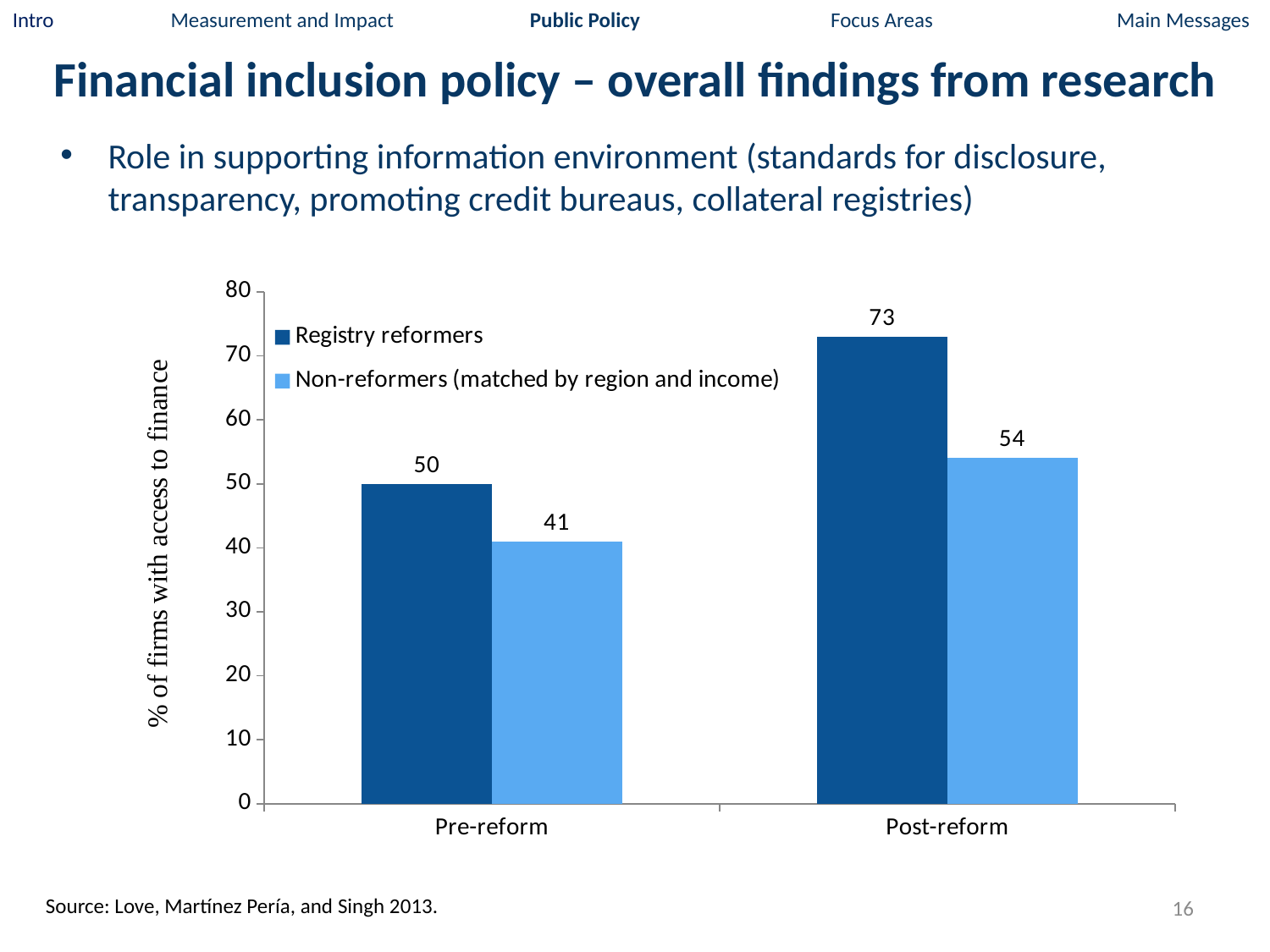
By how much did the Registry reformers value increase from Pre-reform to Post-reform? 23 How many series does the legend list? 2 Which is larger: Non-reformers Post-reform or Registry reformers Pre-reform? Non-reformers Post-reform Which category has the highest value for Registry reformers? Post-reform What is the difference between Registry reformers and Non-reformers in the Post-reform category? 19 What is the value for Registry reformers in the Pre-reform category? 50 What kind of chart is shown on the slide? Bar chart Which series has the lowest value in the Pre-reform category? Non-reformers (matched by region and income) What is the value for Non-reformers (matched by region and income) in the Post-reform category? 54 What is the value for Registry reformers in the Post-reform category? 73 What is the label of the y axis? % of firms with access to finance How many categories are shown on the x axis? 2